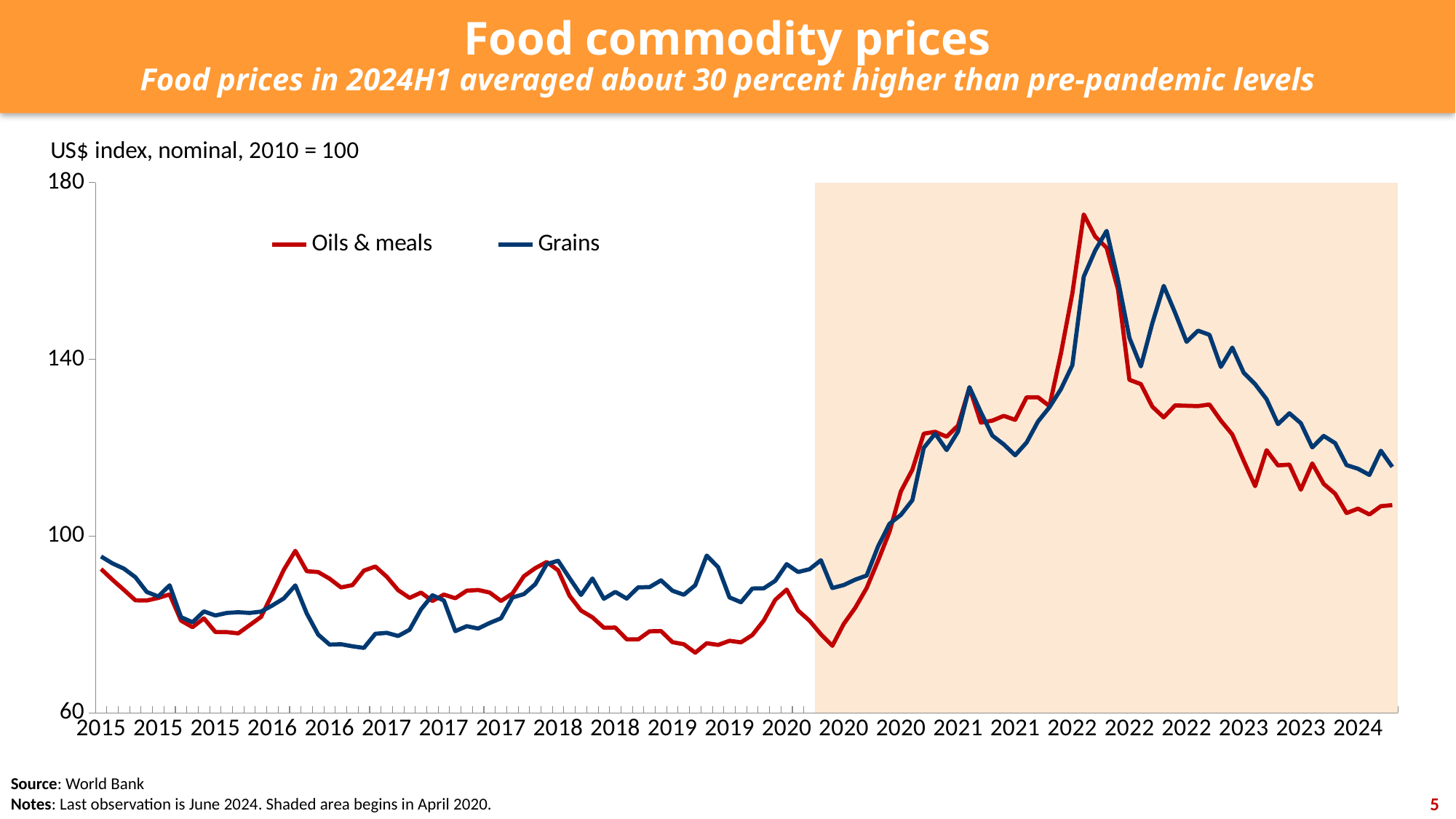
Is the value of the Grains series in late 2016 greater or less than 100? less Is the peak value of the Oils & meals series in 2022 greater or less than 140? greater What are the two series named in the legend? Oils & meals and Grains What kind of chart is shown on the slide? Line chart During 2019, which series is higher, Oils & meals or Grains? Grains Is the value of the Oils & meals series during 2019 greater or less than 100? less How many series does the legend list? 2 What is the unit label shown above the chart's y axis? US$ index, nominal, 2010 = 100 Do the Grains values rise or fall between mid-2022 and 2024? Fall At the last observation in 2024, which series is higher, Oils & meals or Grains? Grains Do the Oils & meals values rise or fall between mid-2020 and early 2022? Rise